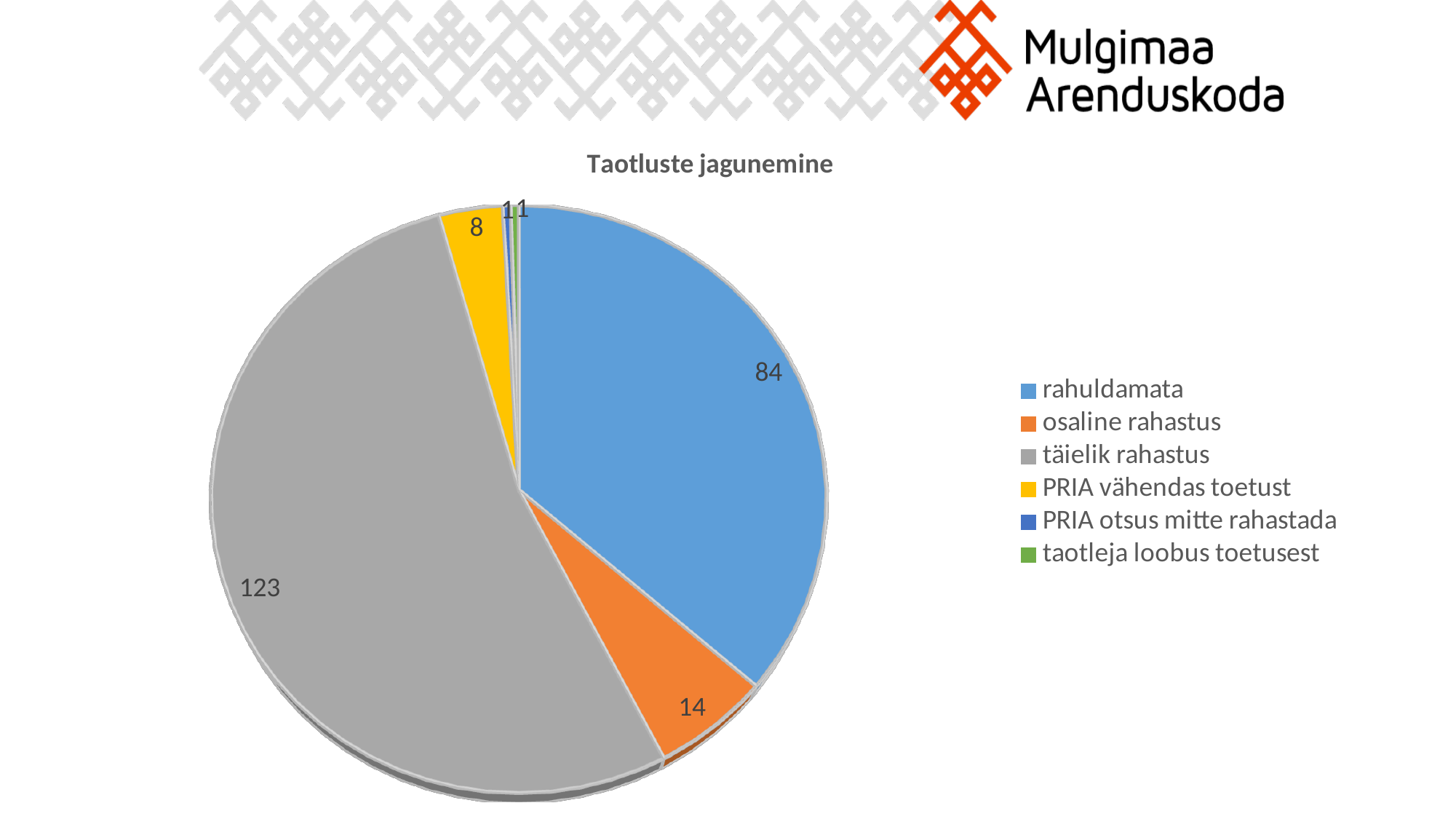
What is the difference between the values for täielik rahastus and rahuldamata? 39 What is the title of the chart? Taotluste jagunemine What colour is the slice for rahuldamata? blue What is the value for PRIA vähendas toetust? 8 Which is larger, the value for osaline rahastus or the value for PRIA vähendas toetust? osaline rahastus What type of chart is shown on the slide? pie chart What is the difference between the values for rahuldamata and osaline rahastus? 70 Which category has the largest slice of the pie? täielik rahastus What is the value for osaline rahastus? 14 What is the value for rahuldamata? 84 What is the value for täielik rahastus? 123 How many categories does the legend list? 6